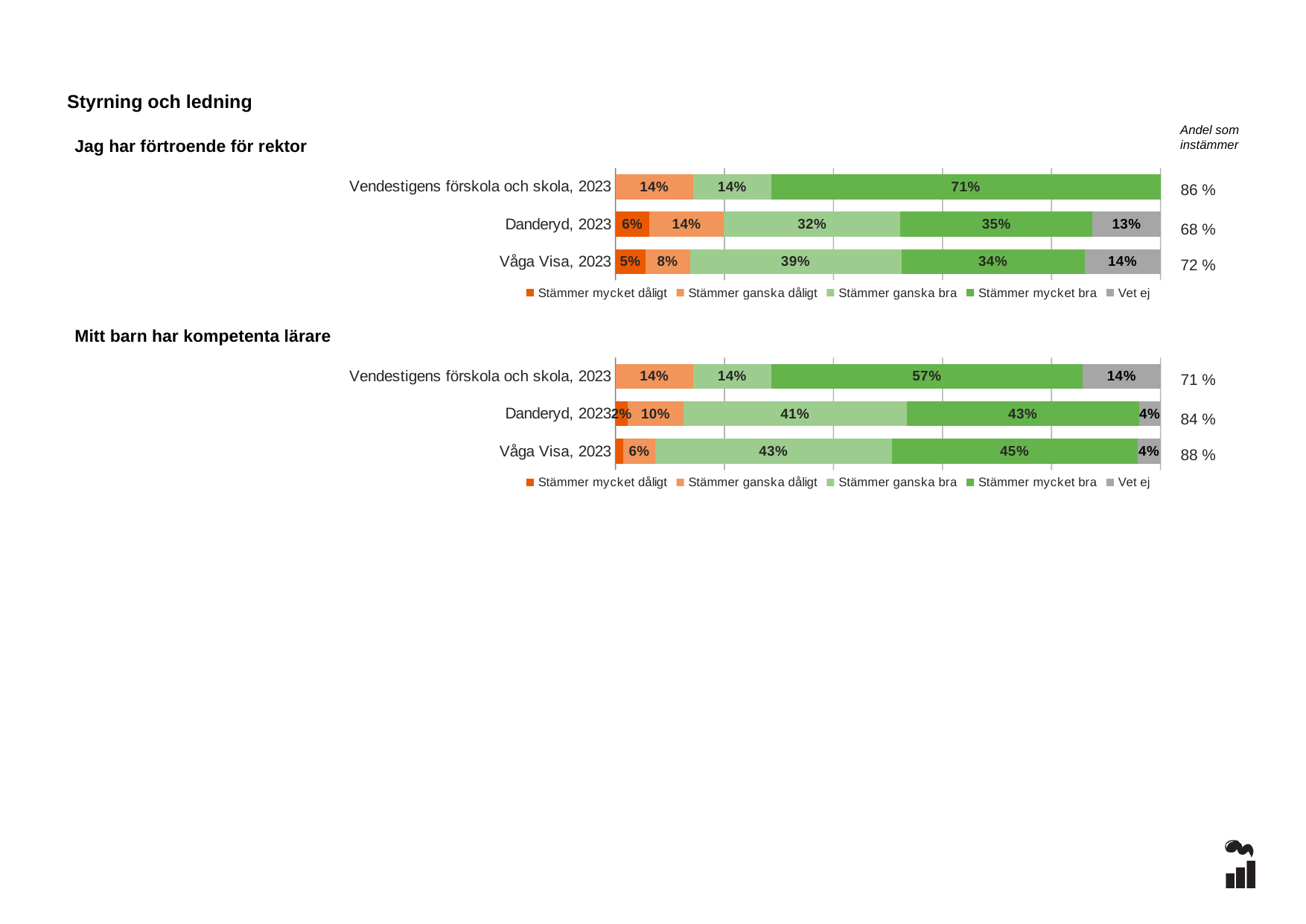
In the chart 'Jag har förtroende för rektor', what is the difference between the 'Stämmer mycket bra' values for Danderyd, 2023 and Våga Visa, 2023? 1% How many categories are shown in the chart 'Mitt barn har kompetenta lärare'? 3 In the chart 'Jag har förtroende för rektor', what is the 'Stämmer ganska bra' value for Våga Visa, 2023? 39% In the chart 'Mitt barn har kompetenta lärare', what is the 'Stämmer mycket bra' value for Våga Visa, 2023? 45% What kind of chart is 'Jag har förtroende för rektor'? Stacked bar chart In the chart 'Mitt barn har kompetenta lärare', what is the 'Stämmer ganska bra' value for Danderyd, 2023? 41% In the chart 'Jag har förtroende för rektor', what is the 'Stämmer mycket bra' value for Vendestigens förskola och skola, 2023? 71% In the chart 'Mitt barn har kompetenta lärare', which category has the lowest 'Stämmer ganska dåligt' value? Våga Visa, 2023 In the chart 'Jag har förtroende för rektor', what is the 'Vet ej' value for Danderyd, 2023? 13% How many series does the legend of the chart 'Jag har förtroende för rektor' list? 5 In the chart 'Jag har förtroende för rektor', which category has the highest 'Stämmer mycket bra' value? Vendestigens förskola och skola, 2023 In the chart 'Mitt barn har kompetenta lärare', which is larger: the 'Stämmer mycket bra' value for Vendestigens förskola och skola, 2023 or for Danderyd, 2023? Vendestigens förskola och skola, 2023